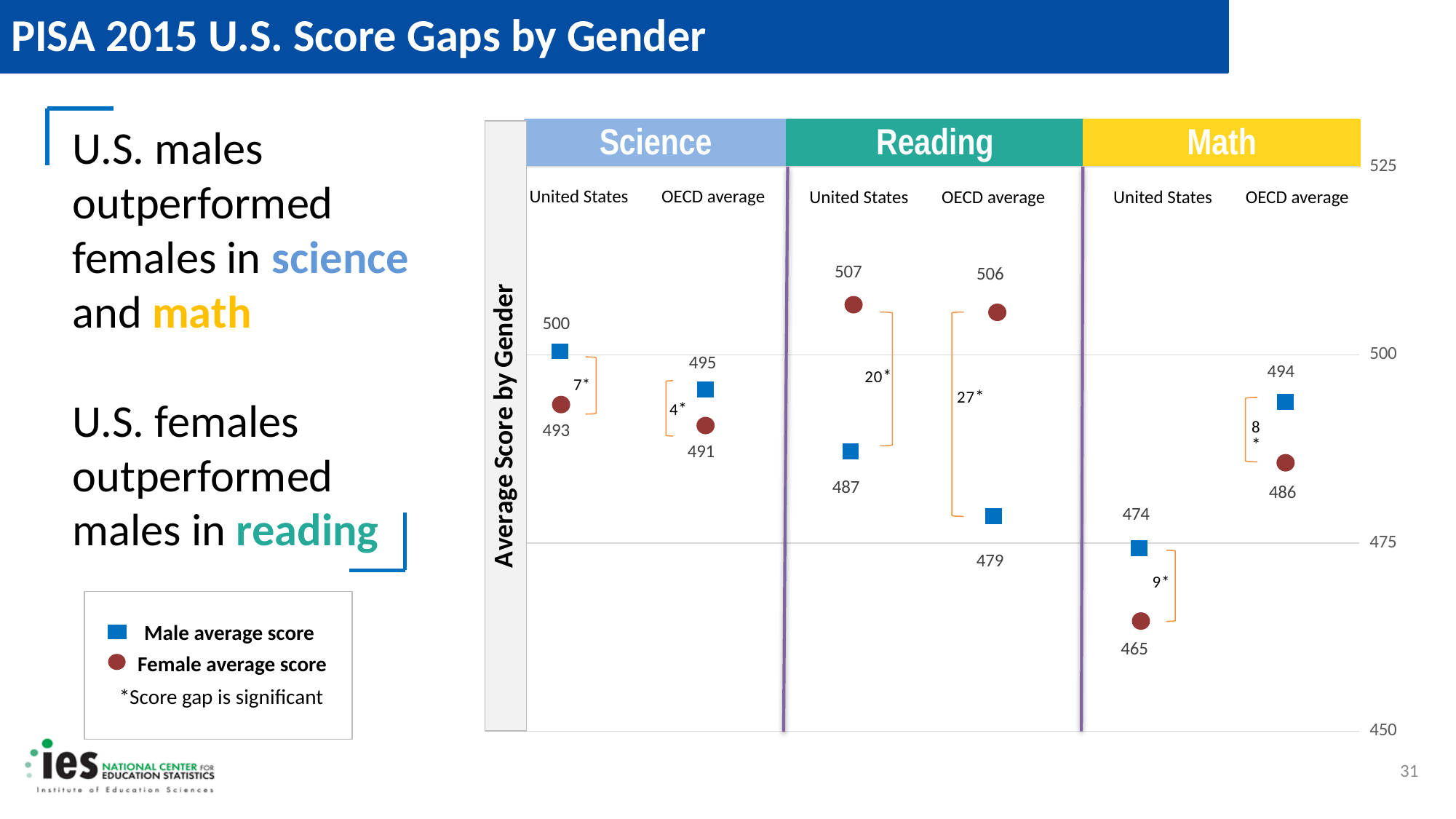
What is the U.S. female average score in reading? 507 Is the U.S. male average score in math greater or less than 475? less Which is higher in science for the United States, the male average score or the female average score? Male average score Which plotted score is the lowest on the chart? U.S. female average score in math (465) Which is higher in reading for the OECD average, the male average score or the female average score? Female average score What is the U.S. male average score in science? 500 What is the difference between the OECD average female and male scores in reading? 27 What is the U.S. female average score in math? 465 Which plotted score is the highest on the chart? U.S. female average score in reading (507) What is the OECD average male score in math? 494 What is the difference between the U.S. female and male average scores in reading? 20 How many series does the legend list? 2